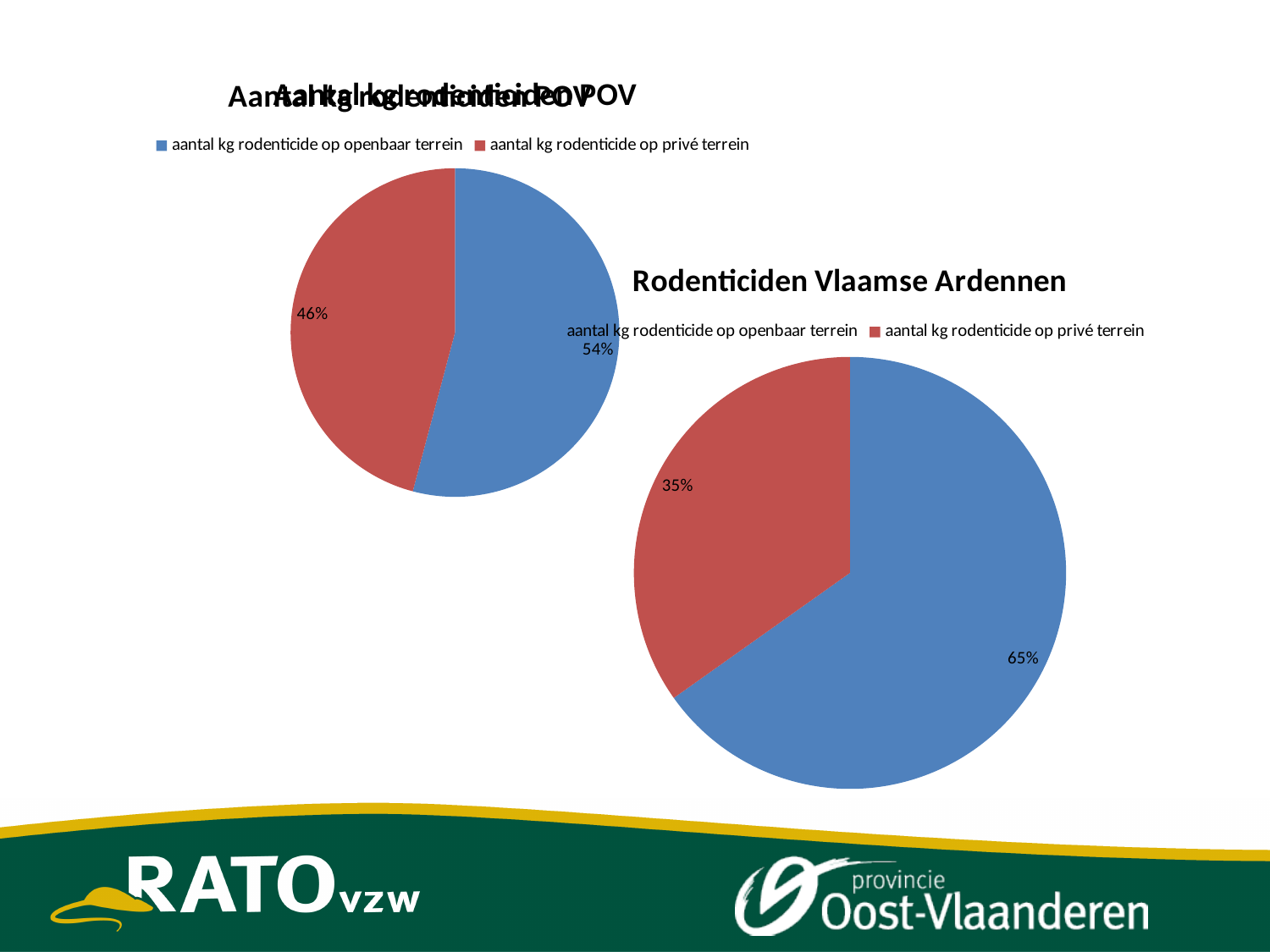
In the Rodenticiden Vlaamse Ardennen chart, what share is labelled for aantal kg rodenticide op openbaar terrein? 65% In the Rodenticiden Vlaamse Ardennen chart, what colour is the slice for aantal kg rodenticide op privé terrein? red In the pie chart on the left, what share is labelled for aantal kg rodenticide op openbaar terrein? 54% In the pie chart on the left, what is the difference in percentage points between the openbaar terrein slice and the privé terrein slice? 8 In the Rodenticiden Vlaamse Ardennen chart, which category has the largest slice? aantal kg rodenticide op openbaar terrein In the Rodenticiden Vlaamse Ardennen chart, which is larger: the openbaar terrein slice or the privé terrein slice? aantal kg rodenticide op openbaar terrein What kind of chart is the Rodenticiden Vlaamse Ardennen chart? pie chart In the Rodenticiden Vlaamse Ardennen chart, what is the difference in percentage points between the openbaar terrein slice and the privé terrein slice? 30 In the pie chart on the left, which category has the smallest slice? aantal kg rodenticide op privé terrein How many slices does the pie chart on the left have? 2 In the pie chart on the left, what share is labelled for aantal kg rodenticide op privé terrein? 46%